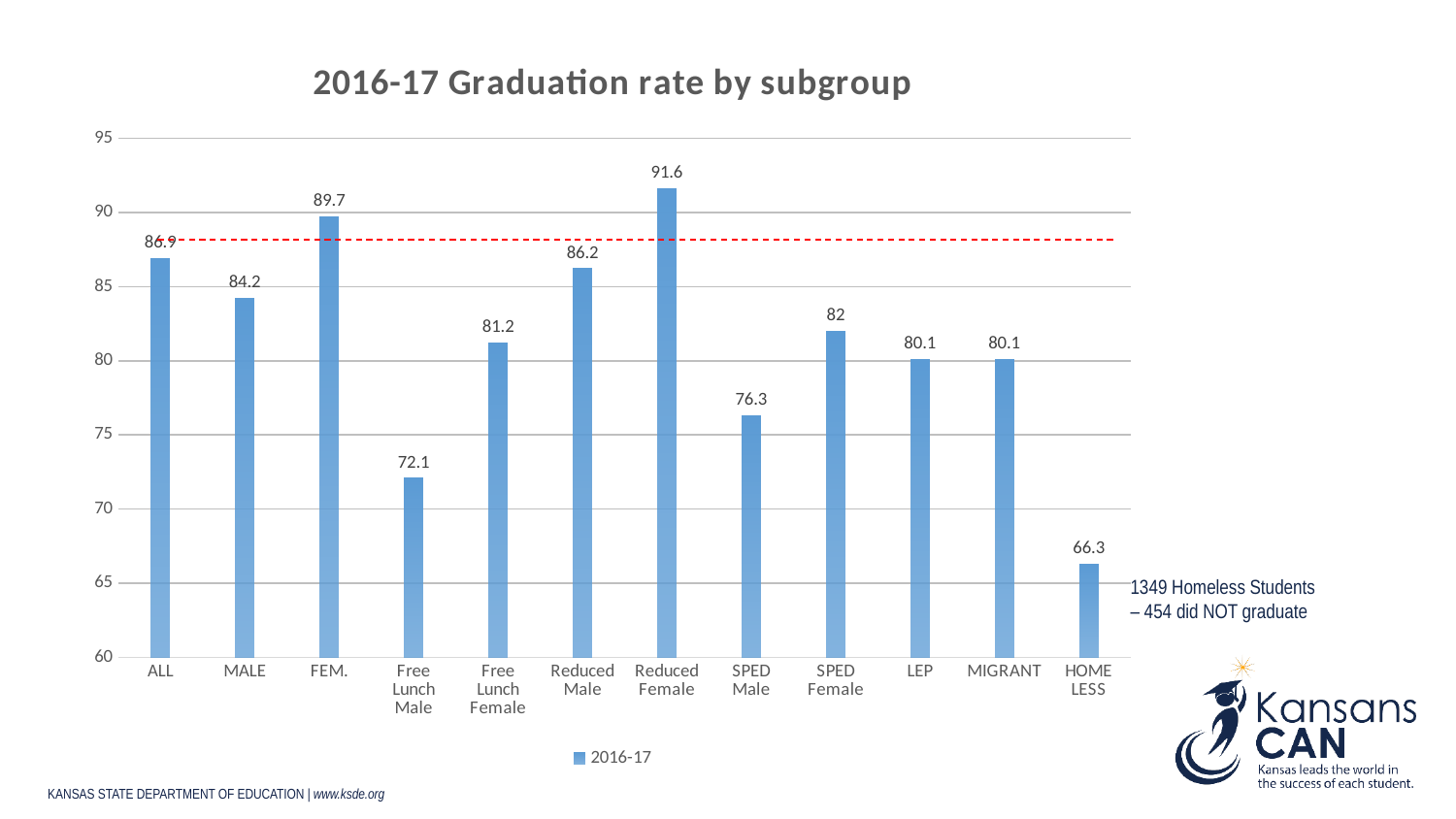
How many series does the legend list? 1 What is the difference between the graduation rates for FEM. and MALE? 5.5 What is the title of the chart? 2016-17 Graduation rate by subgroup Which has a higher graduation rate, SPED Male or Free Lunch Female? Free Lunch Female What kind of chart is shown on the slide? bar chart What is the graduation rate for SPED Female? 82 How many subgroups are shown on the x axis? 12 What is the graduation rate for Free Lunch Male? 72.1 Is the graduation rate for HOMELESS greater or less than 70? less Which subgroup has the lowest graduation rate? HOMELESS What is the graduation rate for Reduced Female? 91.6 Which subgroup has the highest graduation rate? Reduced Female